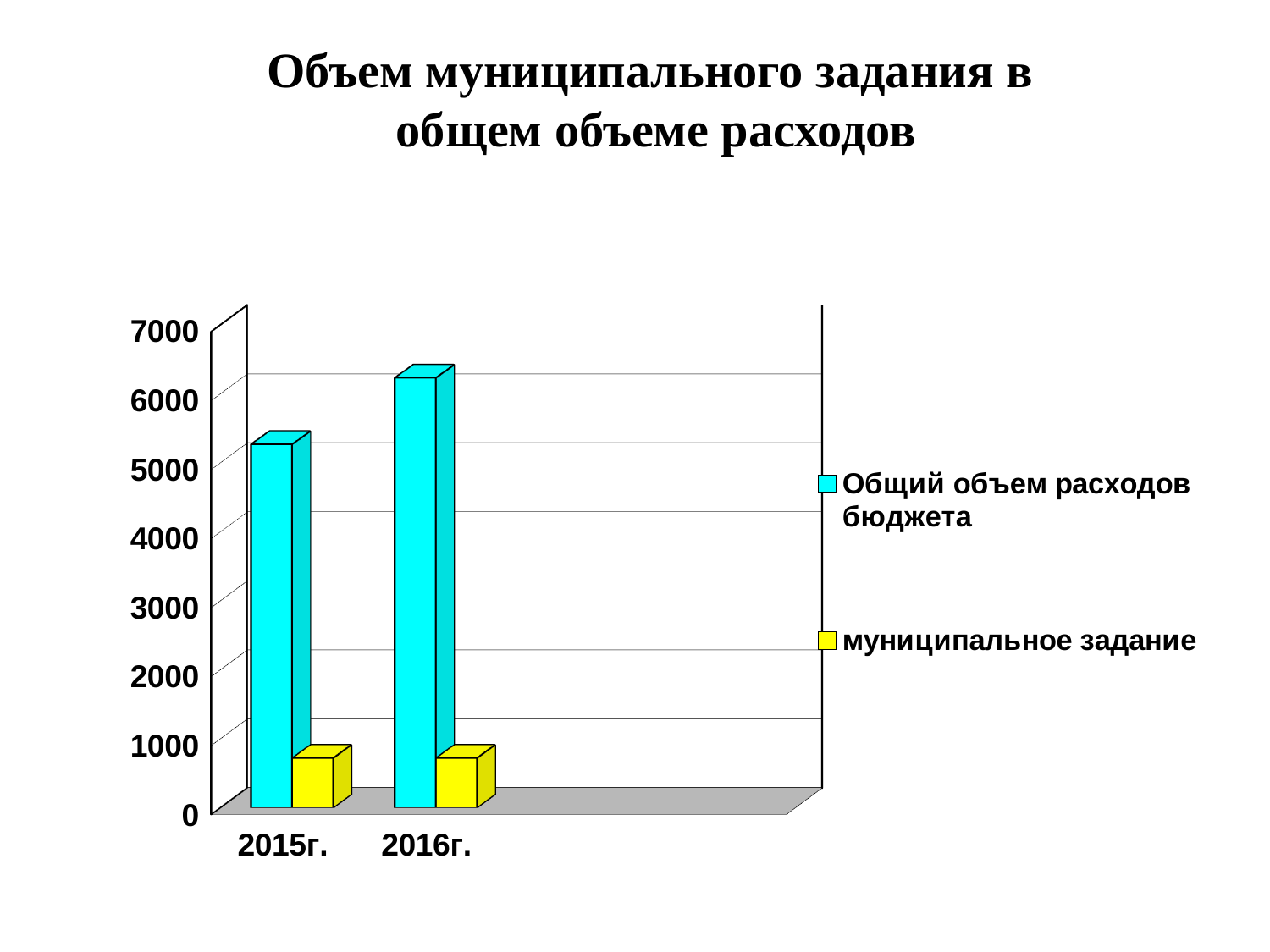
Is the value for Общий объем расходов бюджета in 2016г. greater or less than 5000? greater Does the value for Общий объем расходов бюджета rise or fall from 2015г. to 2016г.? rise What colour represents муниципальное задание in the chart? yellow Is the value for Общий объем расходов бюджета in 2016г. greater or less than 7000? less Which series has the lower values in both years? муниципальное задание Is the value for муниципальное задание in 2016г. greater or less than 2000? less How many series does the legend list? 2 Which year has the higher value for Общий объем расходов бюджета, 2015г. or 2016г.? 2016г. What kind of chart is shown on the slide? bar chart How many categories (years) are shown on the x axis? 2